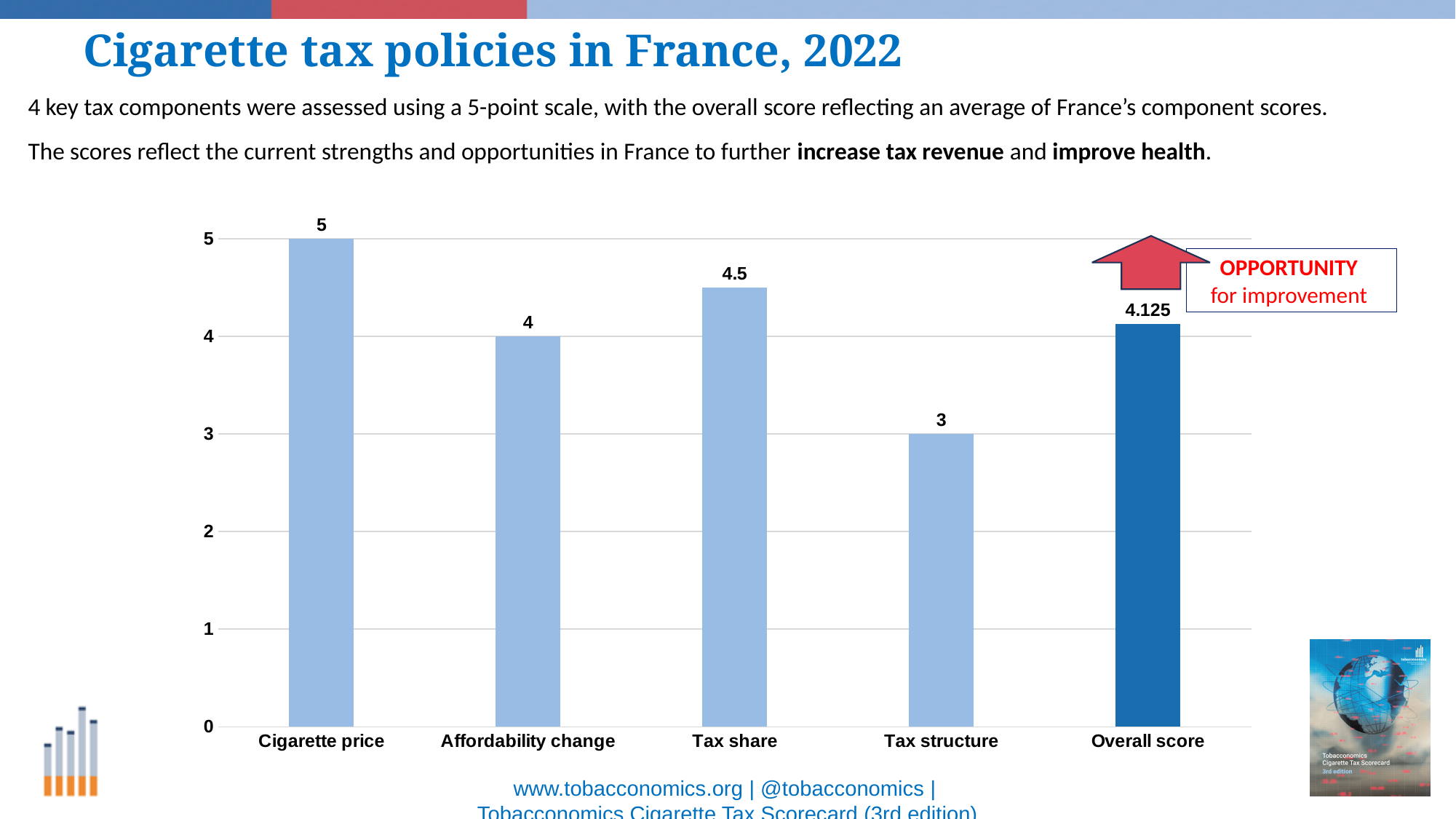
What is the Overall score shown on the chart? 4.125 Which bar is shown in a darker blue than the others? Overall score What kind of chart is shown on the slide? Bar chart What is the score for Tax share? 4.5 Which is larger, the score for Affordability change or the score for Tax share? Tax share What is the difference between the Cigarette price score and the Tax structure score? 2 Which component has the highest score? Cigarette price Is the value for Tax structure greater or less than 4? less Which component has the lowest score? Tax structure What is the score for Tax structure? 3 What is the score for Cigarette price? 5 How many bars are shown on the chart? 5